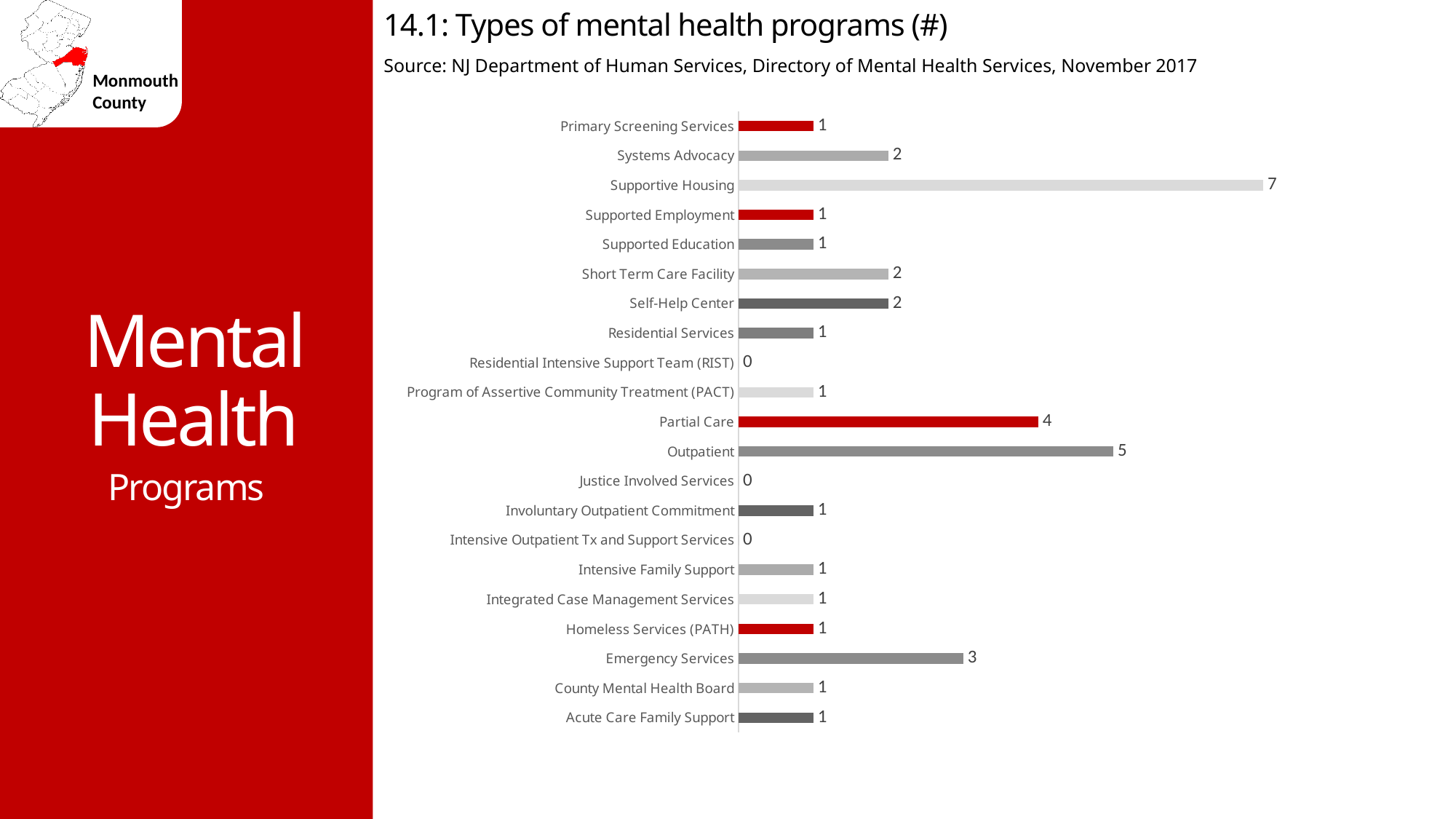
Which category has the highest value? Supportive Housing What is the value for Partial Care? 4 What kind of chart is shown on the slide? Bar chart How many categories have a value of 0? 3 What is the value for Residential Intensive Support Team (RIST)? 0 What is the title of the chart? 14.1: Types of mental health programs (#) What is the value for Outpatient? 5 Which is larger, the value for Partial Care or the value for Emergency Services? Partial Care How many categories are shown on the chart? 21 What is the value for Supportive Housing? 7 What is the value for Emergency Services? 3 What is the difference between the values for Supportive Housing and Outpatient? 2